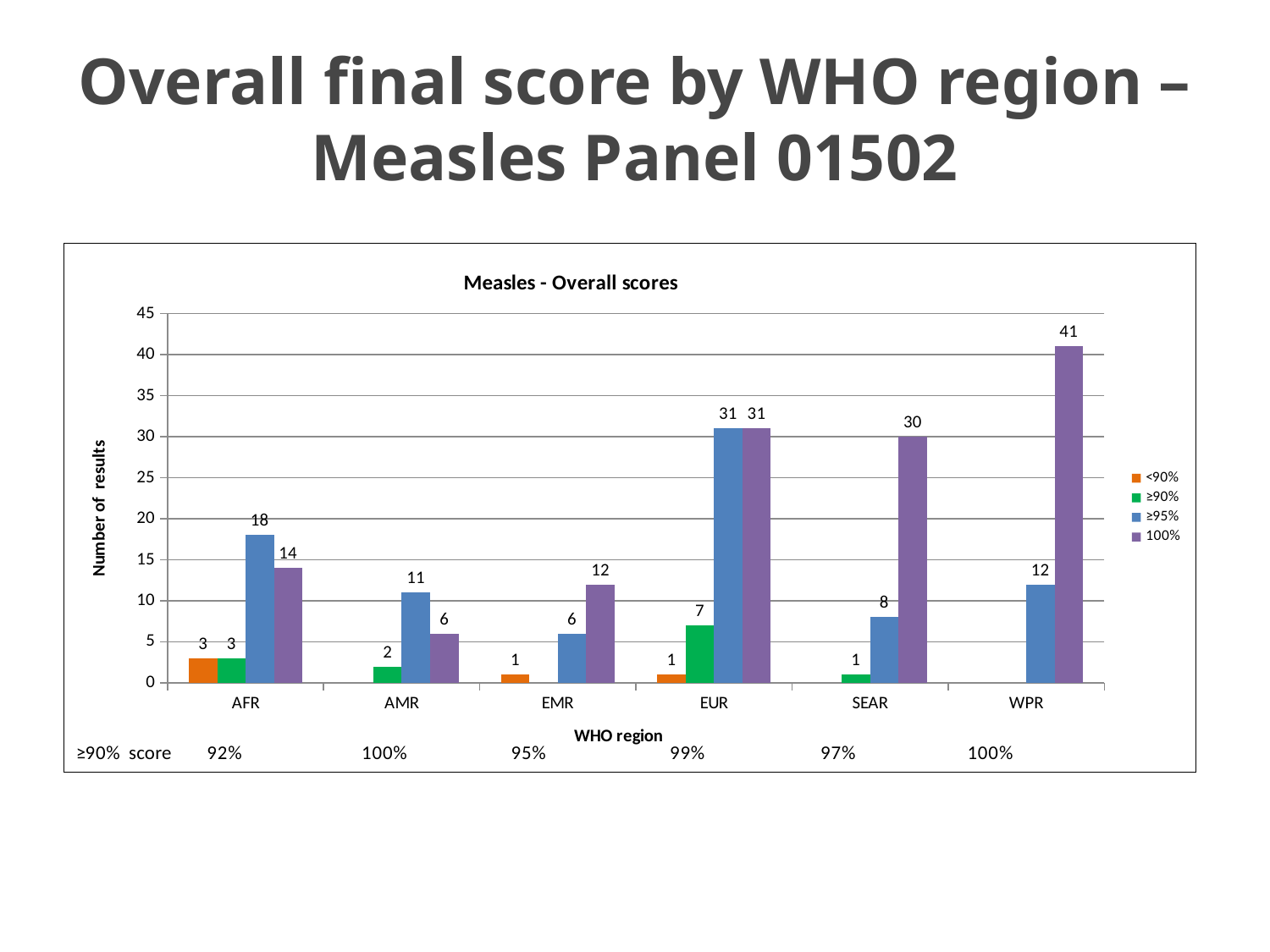
What is the title of the chart? Measles - Overall scores Which is larger for AMR: the ≥95% value or the 100% value? ≥95% What kind of chart is shown? bar chart What is the value of the ≥90% series for EUR? 7 Is the ≥95% value for EUR greater or less than 25? greater Which region has the highest value in the 100% series? WPR How many series does the legend list? 4 How many WHO regions are shown on the x axis? 6 What is the difference between the 100% values for WPR and SEAR? 11 What is the value of the 100% series for WPR? 41 Which region has the lowest value in the ≥95% series? EMR What is the value of the ≥95% series for AFR? 18